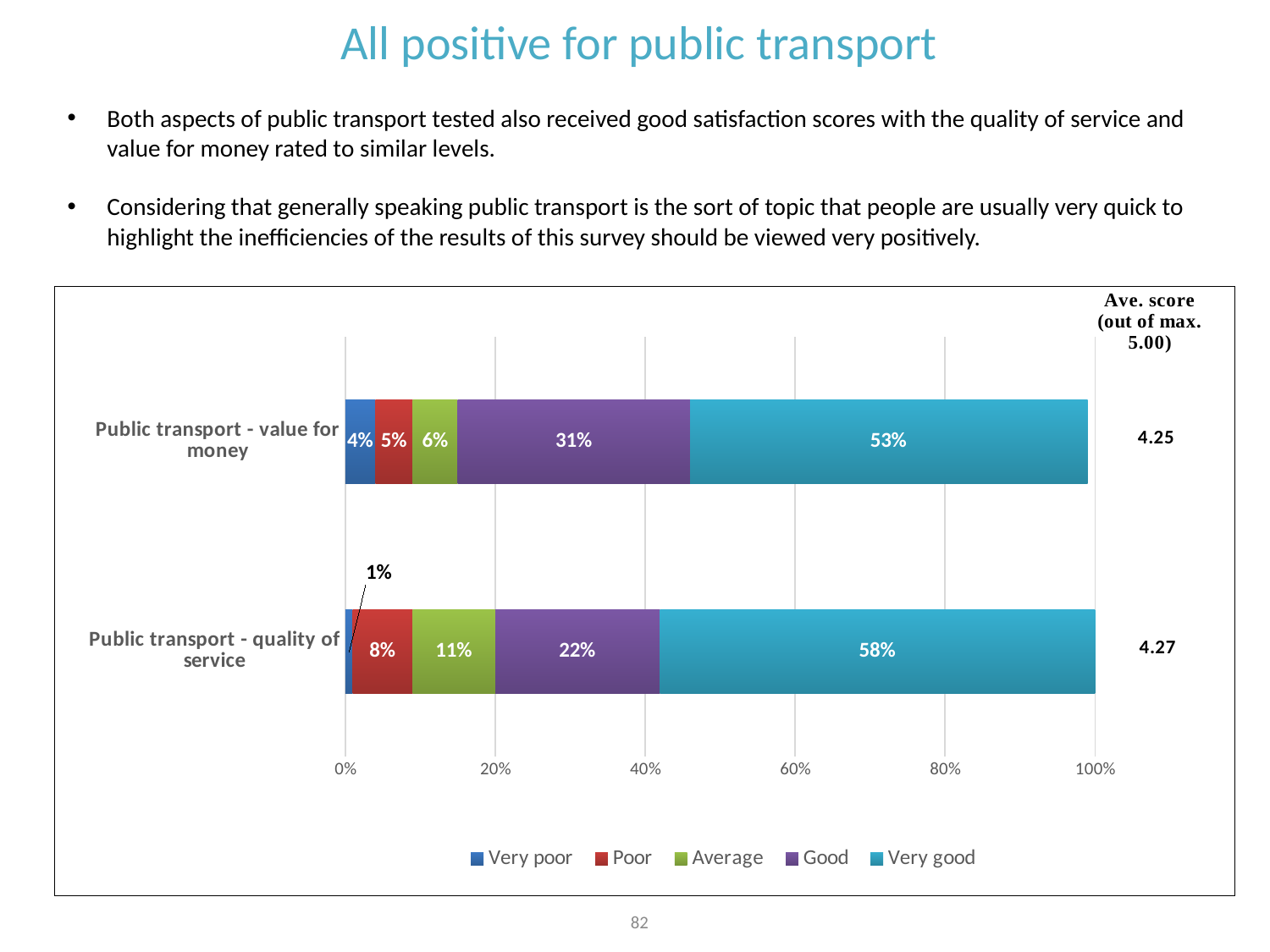
What percentage rated public transport - value for money as 'Very good'? 53% Which category has the higher 'Very good' percentage? Public transport - quality of service How many series does the legend list? 5 How many categories are shown on the chart? 2 What is the average score (out of max. 5.00) for public transport - quality of service? 4.27 Which legend entry is shown in purple? Good What percentage rated public transport - quality of service as 'Good'? 22% What is the difference between the 'Average' percentages for quality of service and value for money? 5% What is the average score (out of max. 5.00) for public transport - value for money? 4.25 What kind of chart is shown on the slide? Stacked bar chart What is the difference between the 'Good' percentages for value for money and quality of service? 9% What percentage rated public transport - quality of service as 'Very poor'? 1%